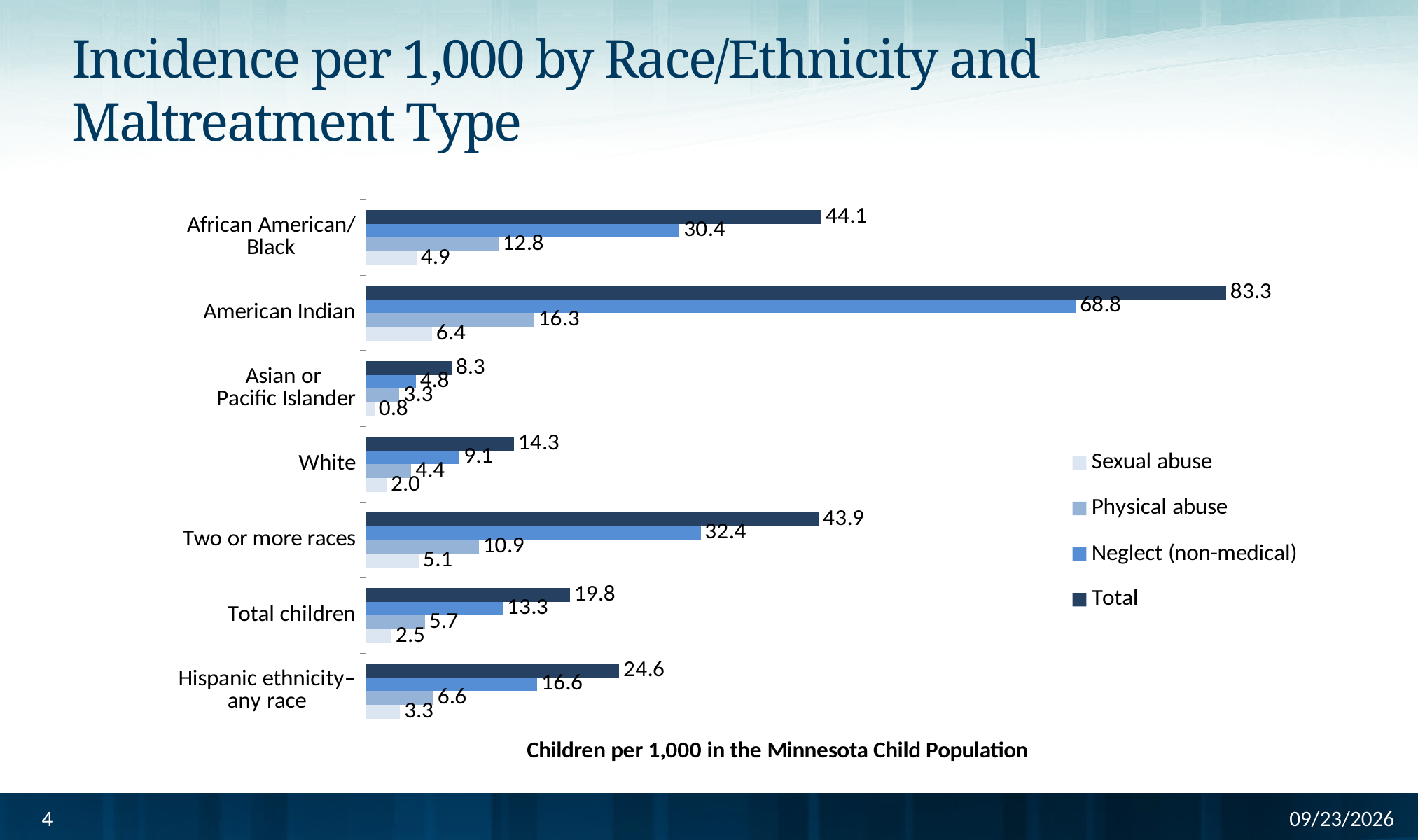
How many series does the legend list? 4 Which race/ethnicity group has the lowest Neglect (non-medical) value? Asian or Pacific Islander What is the Physical abuse value for Hispanic ethnicity–any race? 6.6 What is the Total incidence per 1,000 for American Indian children? 83.3 What is the difference between the Total values for American Indian and White children? 69.0 What is the axis label shown below the chart? Children per 1,000 in the Minnesota Child Population How many race/ethnicity categories are shown on the chart? 7 Which is larger, the Physical abuse value for American Indian or for Two or more races? American Indian Which race/ethnicity group has the highest Total incidence? American Indian What kind of chart is shown on the slide? Bar chart What is the Neglect (non-medical) value for African American/Black children? 30.4 What is the Sexual abuse value for Asian or Pacific Islander children? 0.8